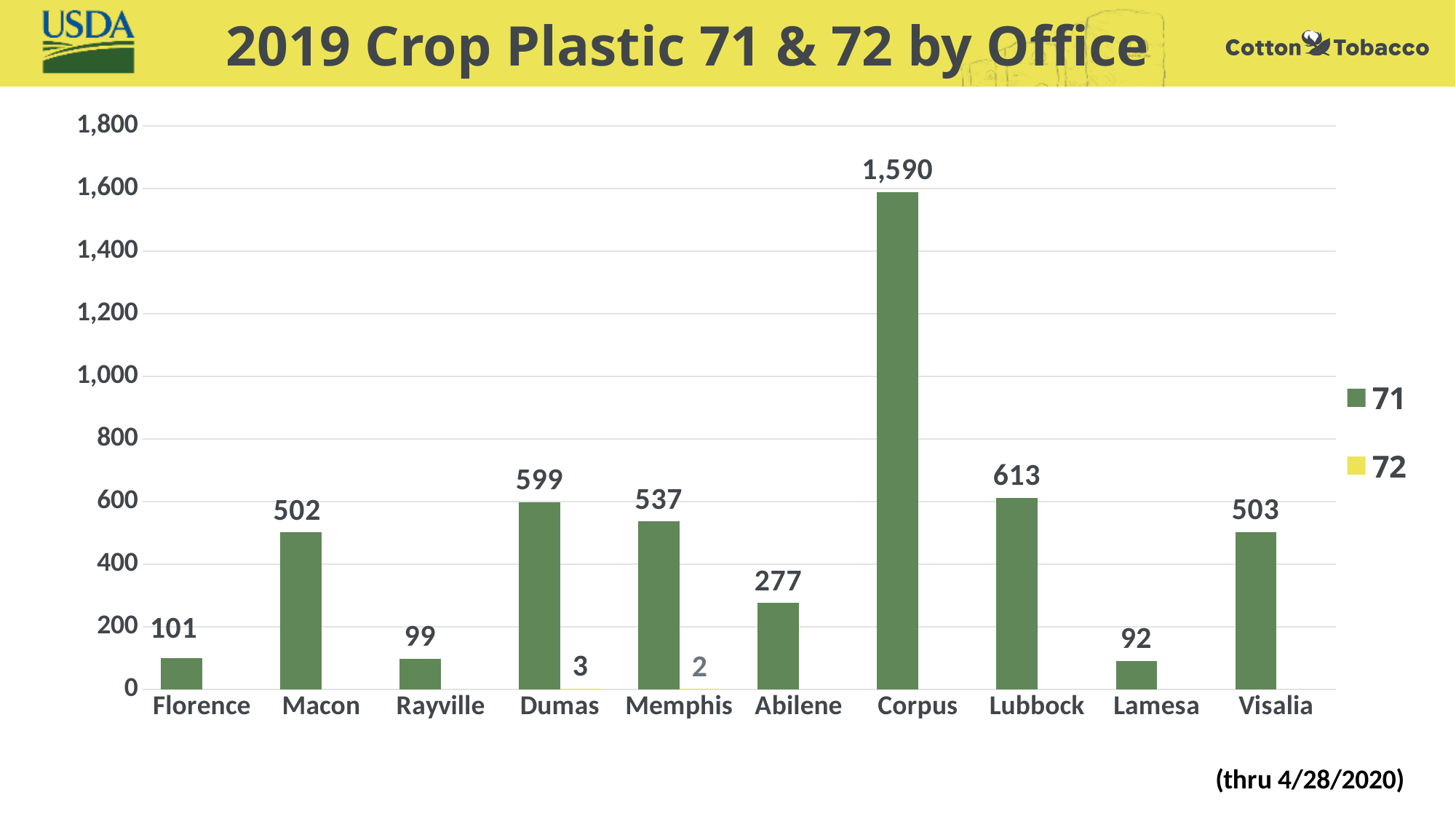
What is the difference between the series 71 values for Corpus and Lubbock? 977 Which office has a larger series 71 value, Dumas or Memphis? Dumas How many series does the legend list? 2 Which office has the lowest value for series 71? Lamesa Is the series 71 value for Abilene greater or less than 400? less How many offices are shown on the x axis? 10 What is the value of series 72 for Dumas? 3 What kind of chart is shown on the slide? bar chart Which office has the highest value for series 71? Corpus What is the value of series 72 for Memphis? 2 What is the value of series 71 for Lubbock? 613 What is the value of series 71 for Corpus? 1,590